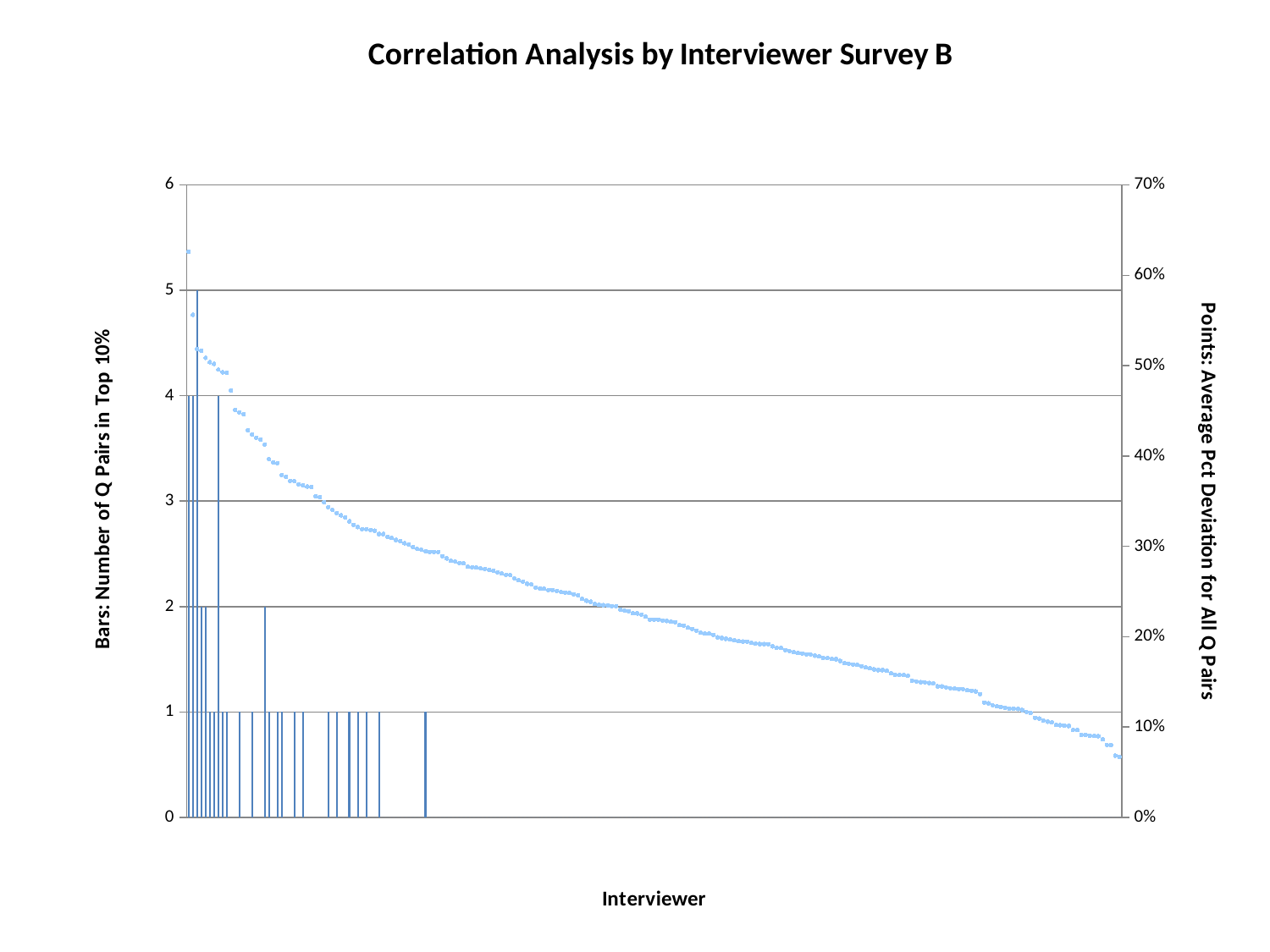
What is the label of the left vertical axis? Bars: Number of Q Pairs in Top 10% Do the plotted points rise or fall from left to right along the x axis? Fall Is the highest point value (leftmost point) greater or less than 50%? greater What kind of chart is this? A combination chart of bars and points (bar chart with a scatter series) What is the height of the tallest bar on the left axis? 5 Is the lowest point value (rightmost point) greater or less than 10%? less What is the title of the chart? Correlation Analysis by Interviewer Survey B Is the tallest bar greater or less than 4 on the left axis? greater Do the bar heights generally rise or fall from left to right along the x axis? Fall